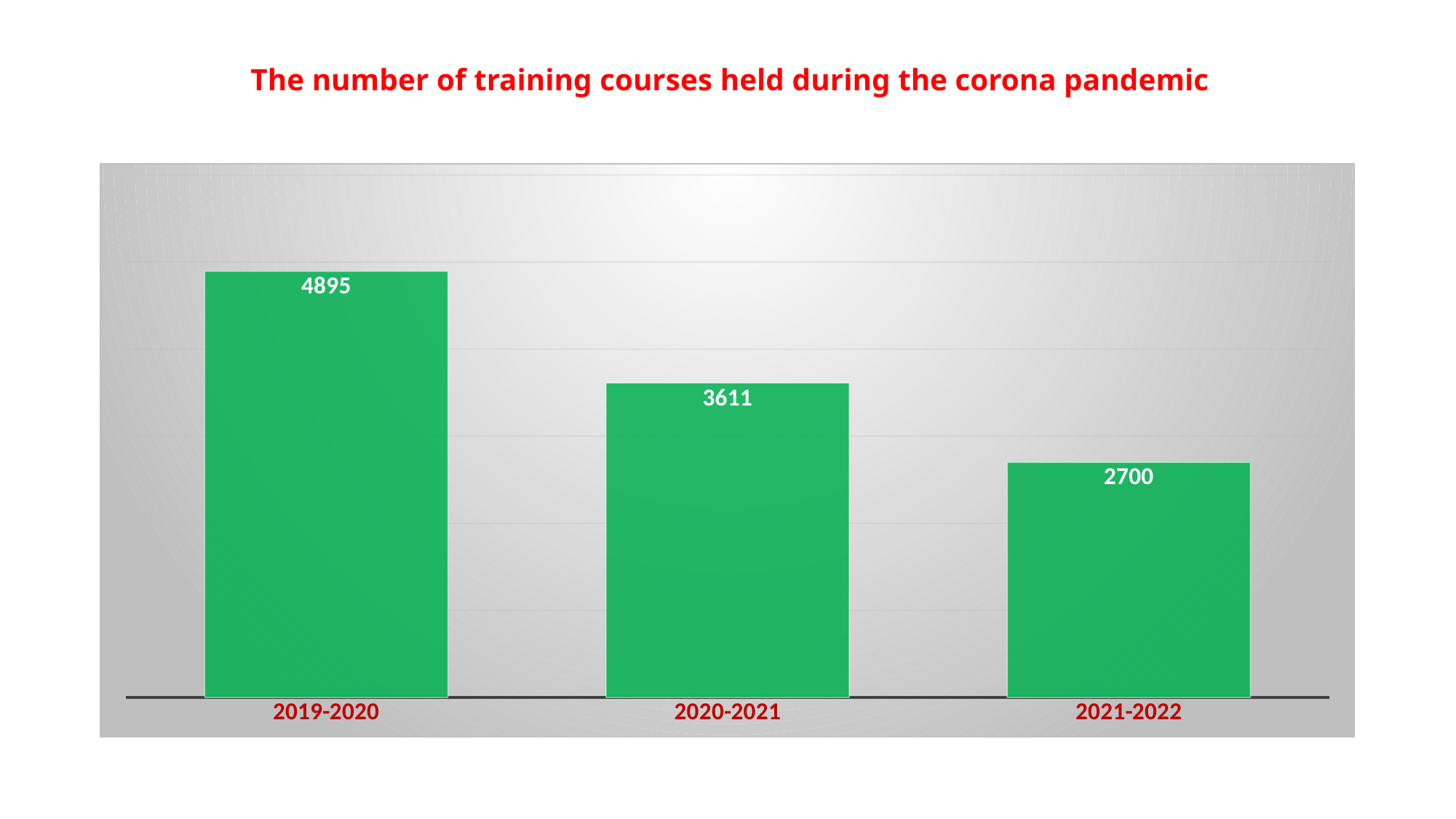
Which period had more training courses, 2020-2021 or 2021-2022? 2020-2021 Which period had the lowest number of training courses? 2021-2022 How many training courses were held in 2019-2020? 4895 What is the title of the chart? The number of training courses held during the corona pandemic What is the difference between the number of training courses in 2019-2020 and 2020-2021? 1284 Which period had the highest number of training courses? 2019-2020 What is the difference between the number of training courses in 2020-2021 and 2021-2022? 911 How many periods are shown on the chart? 3 Do the values rise or fall from 2019-2020 to 2021-2022? Fall What kind of chart is shown on the slide? Bar chart How many training courses were held in 2021-2022? 2700 How many training courses were held in 2020-2021? 3611